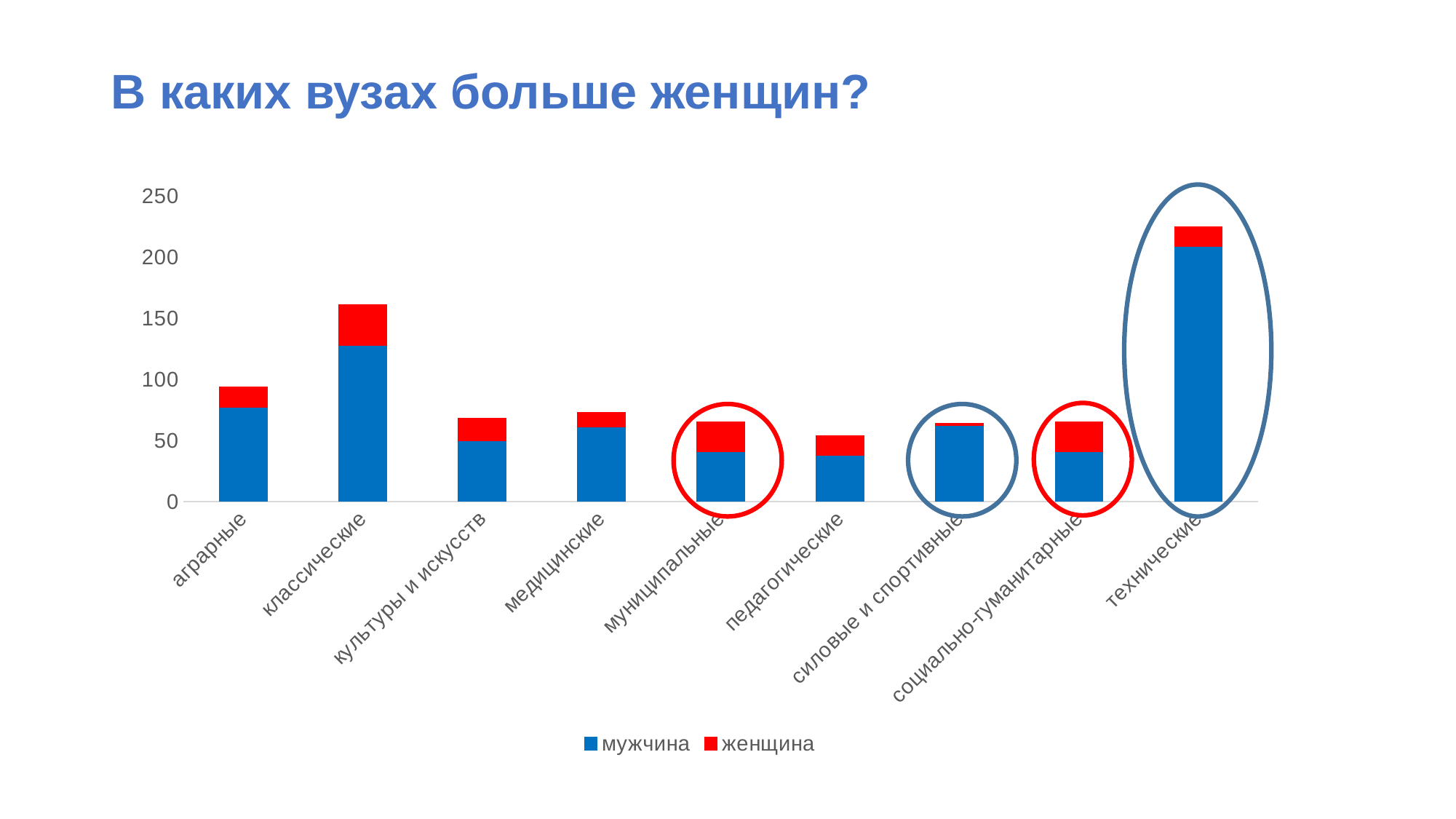
Which category has the shortest stacked bar overall? педагогические What kind of chart is shown on the slide? stacked bar chart Is the total stacked value for классические greater or less than 150? greater Is the total stacked value for технические greater or less than 200? greater Is the мужчина value for классические greater or less than 100? greater How many series does the legend list? 2 Which category has the tallest stacked bar overall? технические Which has the larger total stacked bar, классические or аграрные? классические How many categories of universities are shown on the x axis? 9 Which colour represents the женщина series in the chart? red What is the title of the slide? В каких вузах больше женщин?